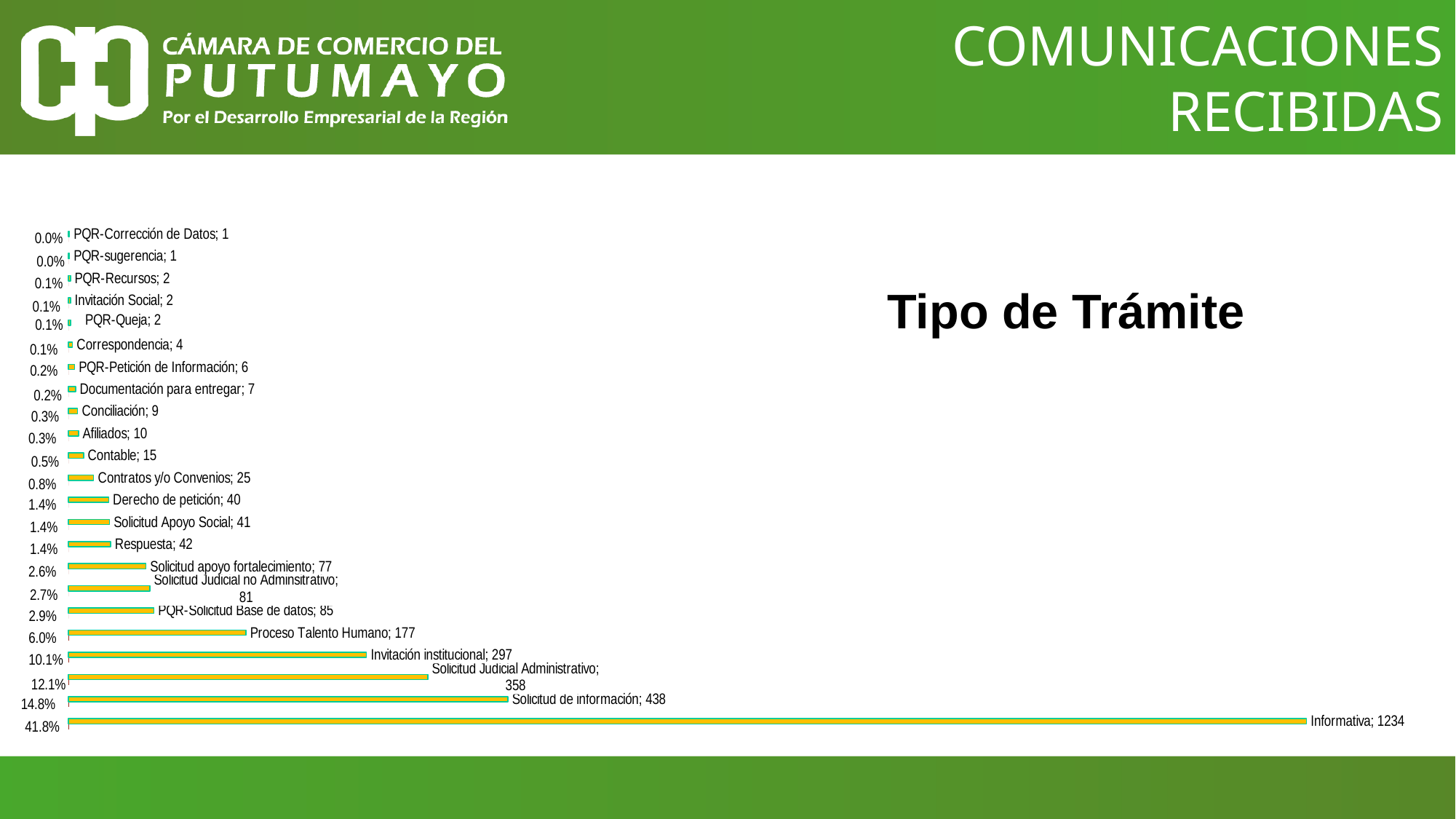
What percentage is shown for Solicitud Judicial Administrativo? 12.1% How many categories are plotted in the chart? 23 What is the title of the chart? Tipo de Trámite What kind of chart is shown on the slide? bar chart Which is larger, the value for Invitación institucional or the value for Proceso Talento Humano? Invitación institucional What is the difference between the values for Informativa and Solicitud de información? 796 What is the difference between the values for Solicitud Judicial Administrativo and Invitación institucional? 61 What is the value for Solicitud de información? 438 What is the value for Informativa? 1234 Which category has the highest value? Informativa What percentage is shown for Informativa? 41.8% What is the value for Proceso Talento Humano? 177